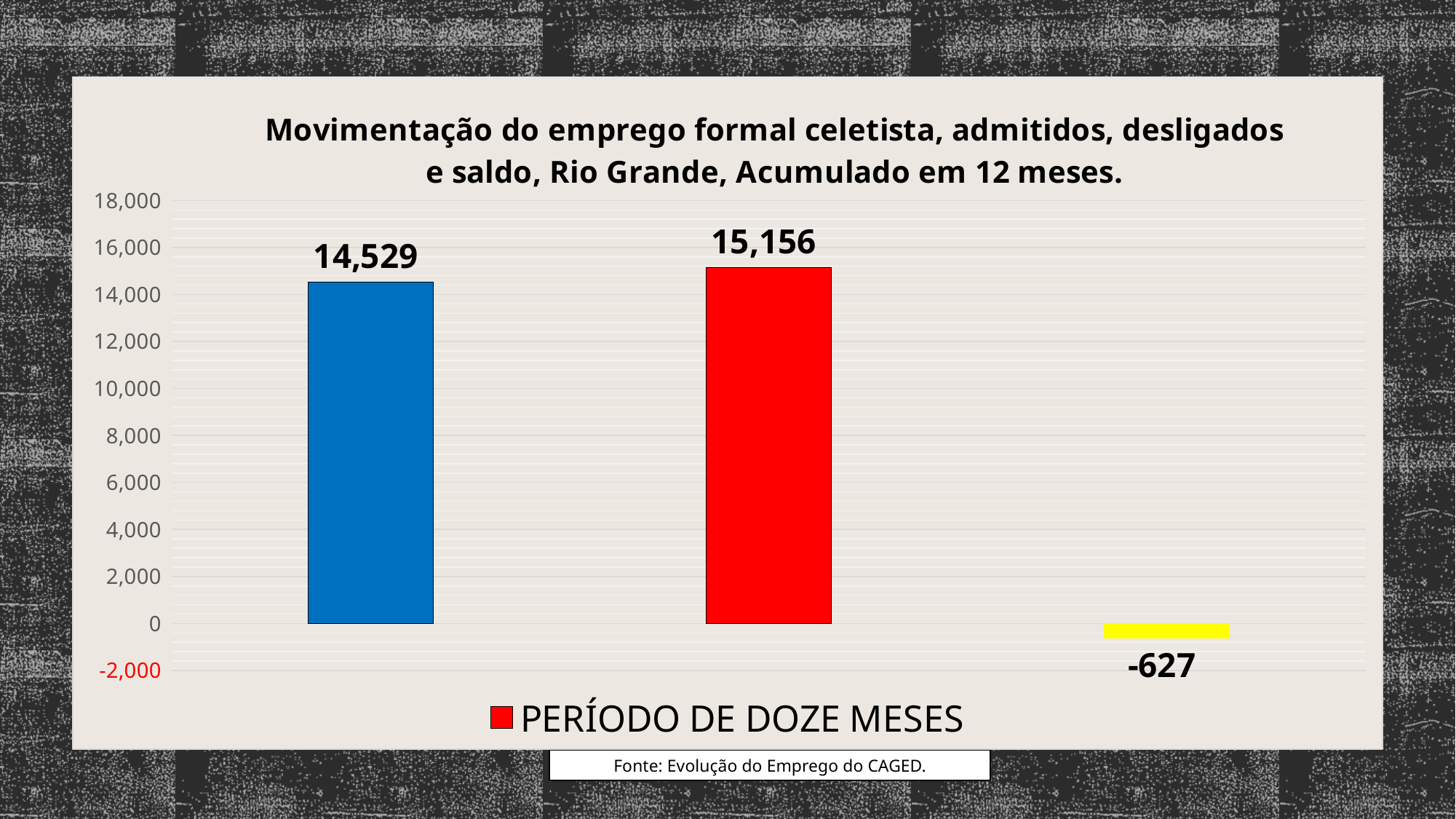
What is the value shown on the yellow bar? -627 What is the value shown on the red bar? 15,156 Which is larger, the value of the blue bar or the value of the red bar? the red bar Which bar has the highest value: the blue, red or yellow one? red What is the value shown on the blue bar? 14,529 What kind of chart is shown on the slide? bar chart What is the difference between the red bar's value and the blue bar's value? 627 How many series does the legend list? 1 Is the value of the blue bar greater or less than 14,000? greater How many bars are plotted in the chart? 3 Which bar has the lowest value: the blue, red or yellow one? yellow What is the legend entry shown below the chart? PERÍODO DE DOZE MESES